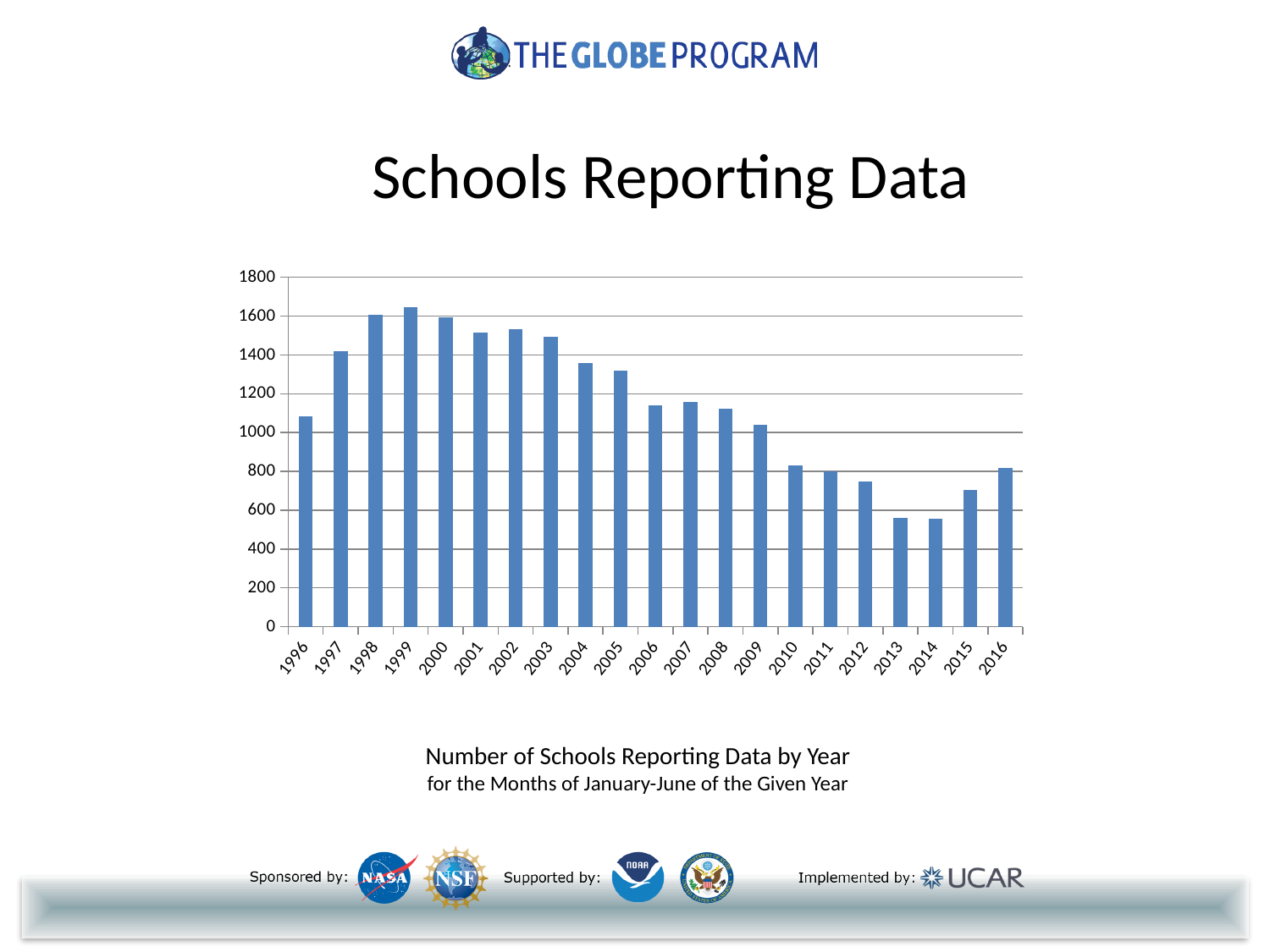
How many years are shown on the x axis of the chart? 21 Is the value for 2012 greater or less than 800? less According to the caption below the chart, which months of each year does the data cover? January-June Do the values generally rise or fall from 1999 to 2014? fall What kind of chart is shown on the slide? bar chart Is the value for 2004 greater or less than 1400? less Is the value for 1996 greater or less than 1000? greater Which year has the highest number of schools reporting data? 1999 Which year has the larger value, 2003 or 2004? 2003 Which year has the larger value, 1997 or 2000? 2000